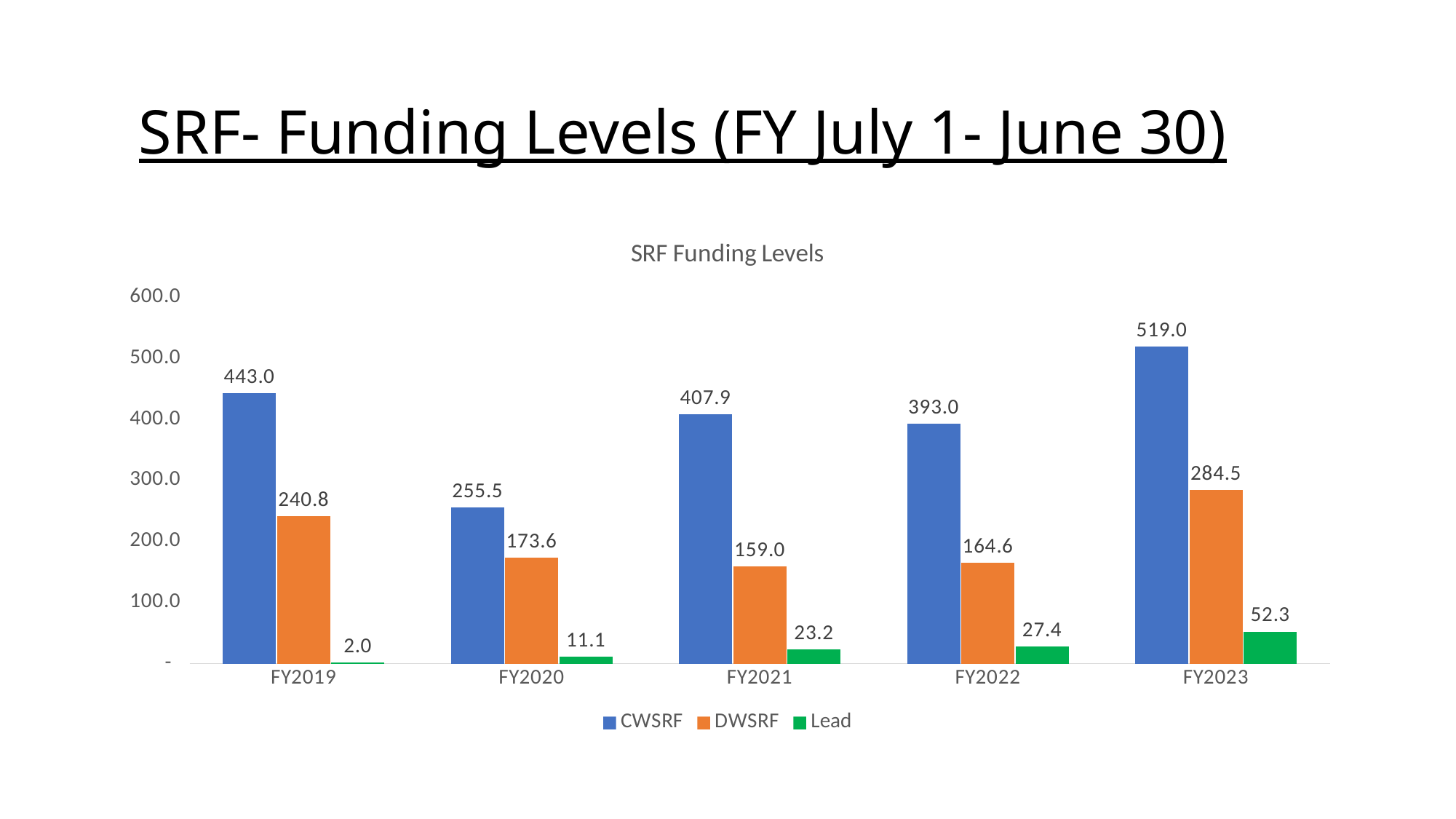
Which fiscal year has the lowest DWSRF value? FY2021 Which is larger, the DWSRF value for FY2022 or the DWSRF value for FY2021? FY2022 What is the difference between the CWSRF and DWSRF values for FY2019? 202.2 Which fiscal year has the highest CWSRF value? FY2023 What is the DWSRF value for FY2020? 173.6 How many series does the legend list? 3 How many fiscal years are shown on the x axis? 5 Do the Lead values rise or fall from FY2019 to FY2023? rise Is the CWSRF value for FY2020 greater or less than 300.0? less What is the Lead value for FY2021? 23.2 What kind of chart is shown on the slide? bar chart What is the CWSRF value for FY2023? 519.0